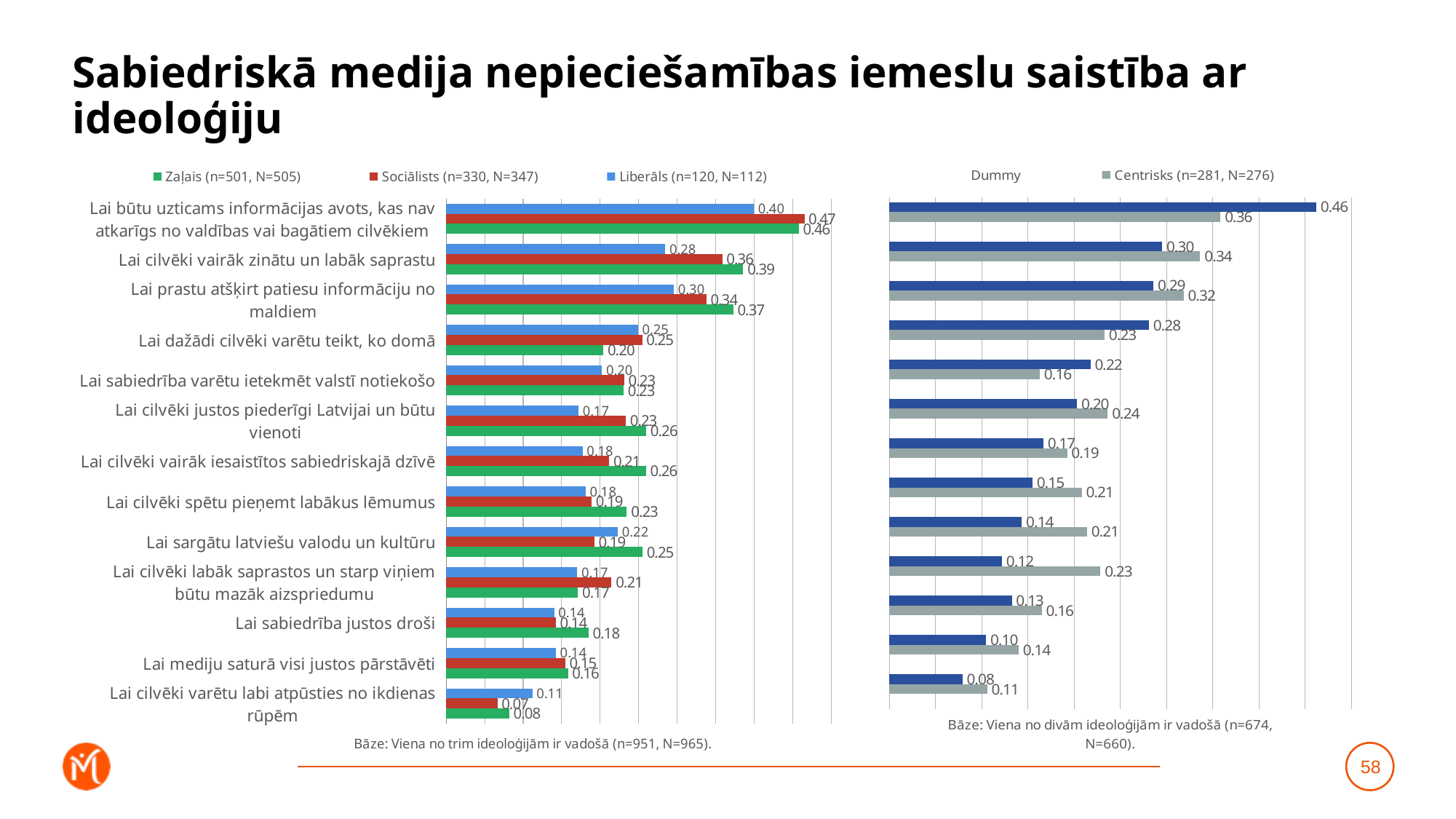
How many categories are shown in the left chart? 13 In the left chart, what is the Liberāls value for 'Lai sargātu latviešu valodu un kultūru'? 0.22 What type of chart is the right chart? Bar chart How many series does the legend of the left chart list? 3 In the left chart, which category has the lowest Sociālists value? Lai cilvēki varētu labi atpūsties no ikdienas rūpēm In the right chart, what is the Centrisks value for 'Lai cilvēki labāk saprastos un starp viņiem būtu mazāk aizspriedumu'? 0.23 In the left chart, what is the value for Sociālists for 'Lai būtu uzticams informācijas avots, kas nav atkarīgs no valdības vai bagātiem cilvēkiem'? 0.47 In the left chart, which is larger for 'Lai cilvēki labāk saprastos un starp viņiem būtu mazāk aizspriedumu': Sociālists or Zaļais? Sociālists In the left chart, what is the difference between the Zaļais and Liberāls values for 'Lai cilvēki vairāk zinātu un labāk saprastu'? 0.11